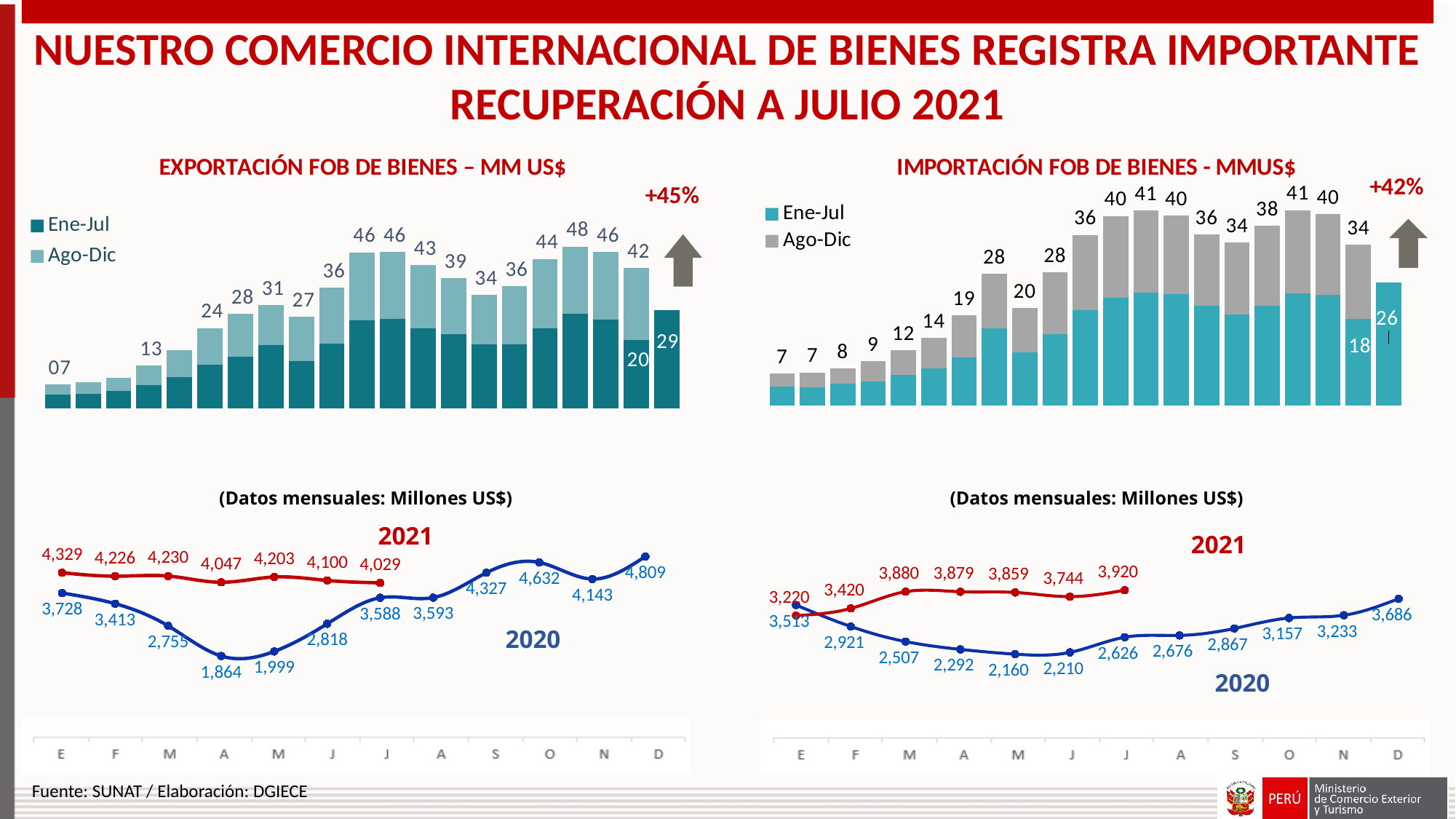
In the bottom-right line chart (Importación, datos mensuales), what is the difference between the 2020 values for December (D) and November (N)? 453 How many data points does the 2020 line have in the bottom-left line chart (Exportación, datos mensuales)? 12 In the top-right bar chart (Importación FOB de bienes), what is the Ene-Jul value of the last bar? 26 How many series does the legend of the top-left bar chart (Exportación FOB de bienes) list? 2 In the bottom-right line chart (Importación, datos mensuales), which month has the lowest 2020 value? M (May), 2,160 In the bottom-left line chart (Exportación, datos mensuales), what is the lowest 2020 value? 1,864 In the top-left bar chart (Exportación FOB de bienes), what percentage change is shown next to the arrow? +45% In the bottom-left line chart (Exportación, datos mensuales), what is the 2021 value for January (E)? 4,329 In the bottom-right line chart (Importación, datos mensuales), what is the 2021 value for July (J)? 3,920 In the bottom-left line chart (Exportación, datos mensuales), what is the difference between the 2021 and 2020 values for April (A)? 2,183 In the bottom-right line chart (Importación, datos mensuales), which is larger for January (E): the 2020 value or the 2021 value? 2020 (3,513) In the top-left bar chart (Exportación FOB de bienes), what is the highest total value labelled on a bar? 48